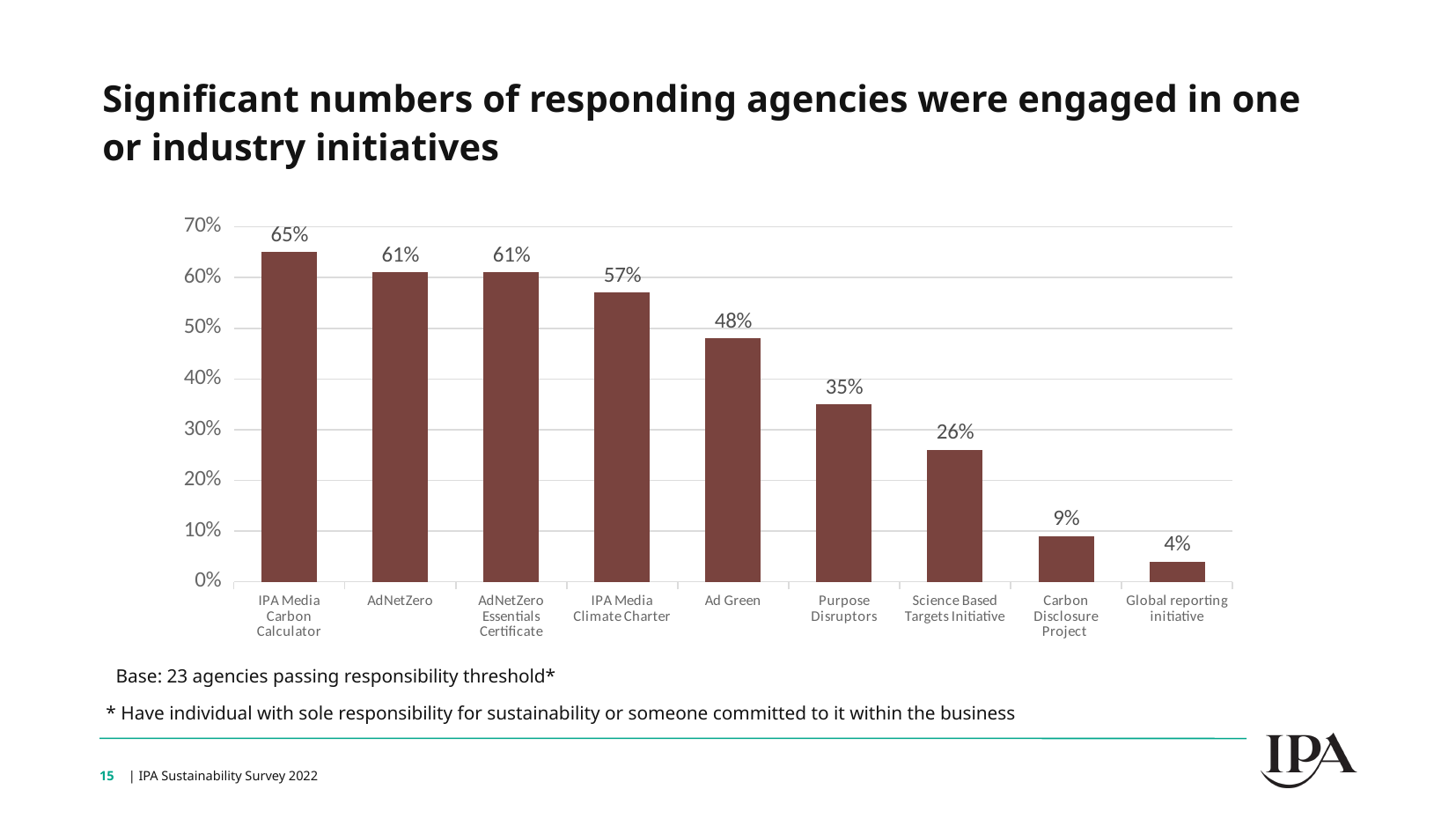
Is the value for Carbon Disclosure Project greater or less than 10%? less Which has a higher value, IPA Media Climate Charter or Purpose Disruptors? IPA Media Climate Charter Do the values rise or fall moving from left to right along the x axis? Fall What is the value shown for Ad Green? 48% What kind of chart is shown on the slide? Bar chart What percentage of agencies were engaged in the IPA Media Carbon Calculator? 65% What percentage is shown for Science Based Targets Initiative? 26% Which initiative has the lowest percentage of engaged agencies? Global reporting initiative How many initiatives are shown on the chart? 9 Which initiative has the highest percentage of engaged agencies? IPA Media Carbon Calculator What is the difference in percentage points between Ad Green and Purpose Disruptors? 13 percentage points What is the base stated below the chart? 23 agencies passing responsibility threshold